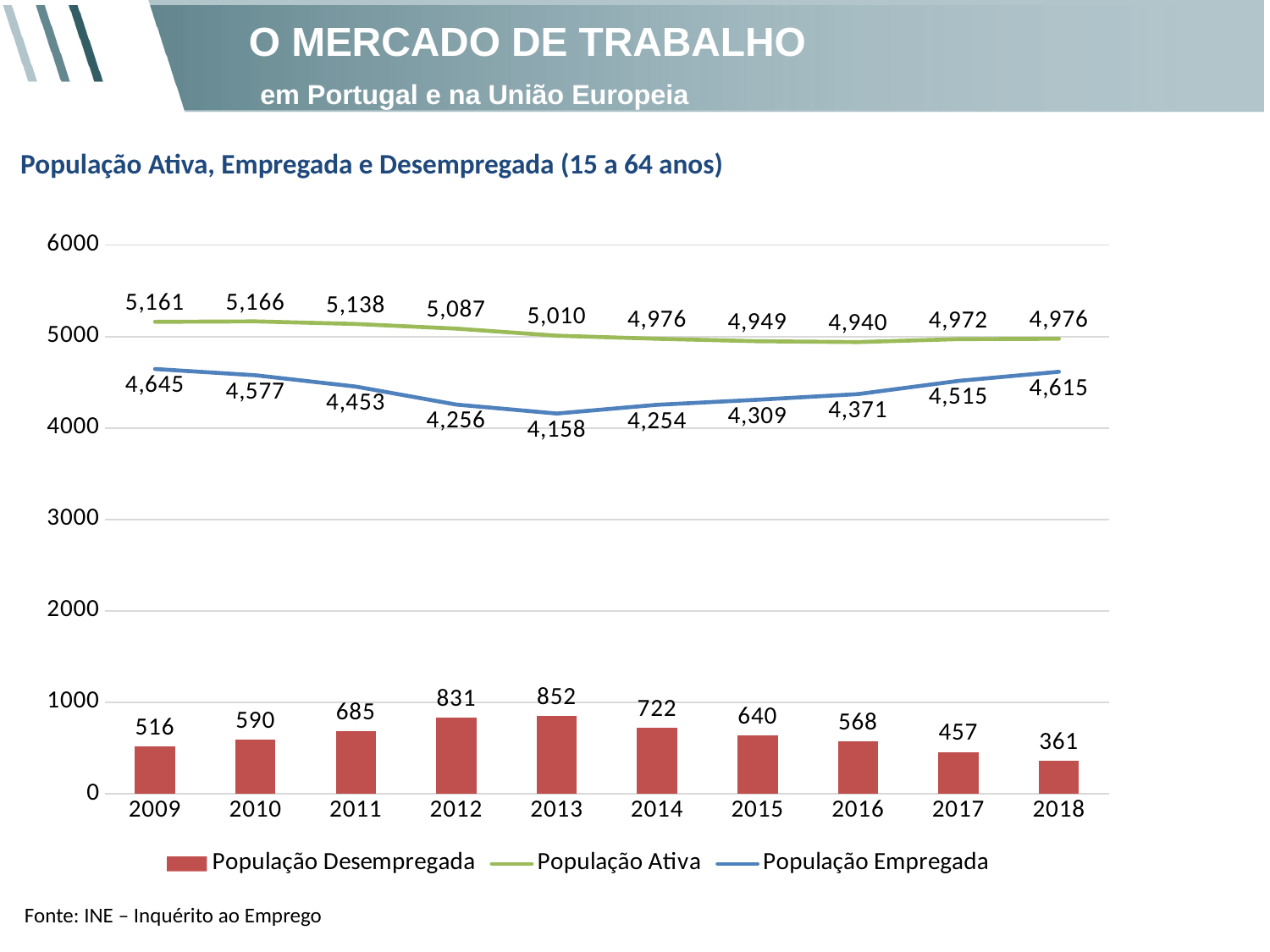
What is the value of População Desempregada in 2013? 852 How many series does the legend list? 3 Which series is shown as bars? População Desempregada Does População Desempregada rise or fall from 2013 to 2018? fall In which year is População Desempregada highest? 2013 What is the value of População Empregada in 2018? 4,615 What is the value of População Ativa in 2009? 5,161 Which is larger: População Desempregada in 2012 or in 2017? 2012 In which year is População Empregada lowest? 2013 How many years are shown on the x axis? 10 What is the difference in População Desempregada between 2009 and 2013? 336 What is the difference between População Ativa and População Empregada in 2018? 361